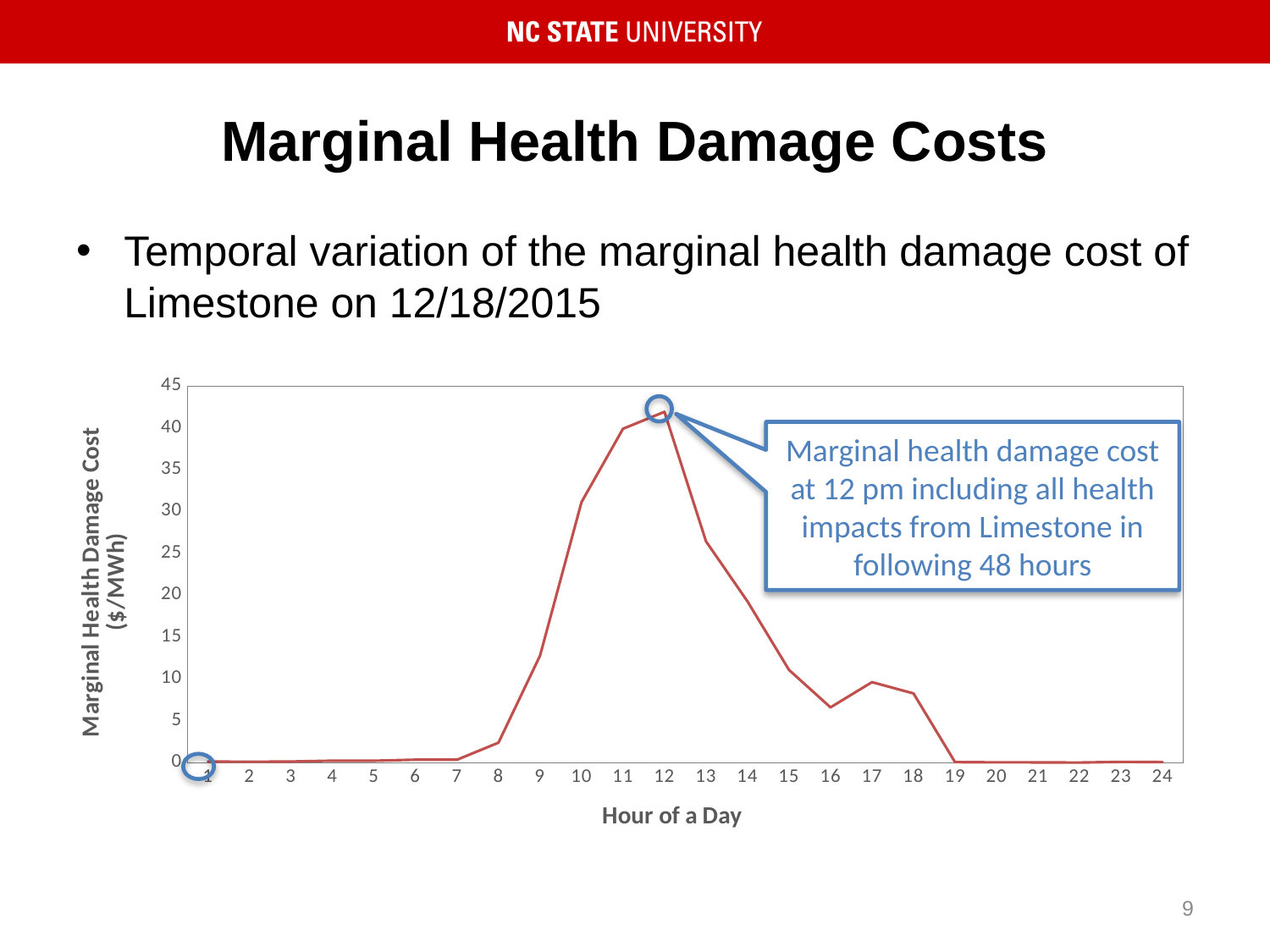
At which hour of the day does the marginal health damage cost reach its highest value? 12 What kind of chart is shown on the slide? line chart What is the title of the x axis? Hour of a Day Is the value at hour 16 greater or less than 5? greater Which hour has the larger marginal health damage cost, hour 17 or hour 16? hour 17 Does the marginal health damage cost rise or fall between hour 12 and hour 19? fall Is the value at hour 12 greater or less than 40? greater How many hours are plotted along the x axis? 24 Is the value at hour 8 greater or less than 5? less Which hour has the larger marginal health damage cost, hour 12 or hour 16? hour 12